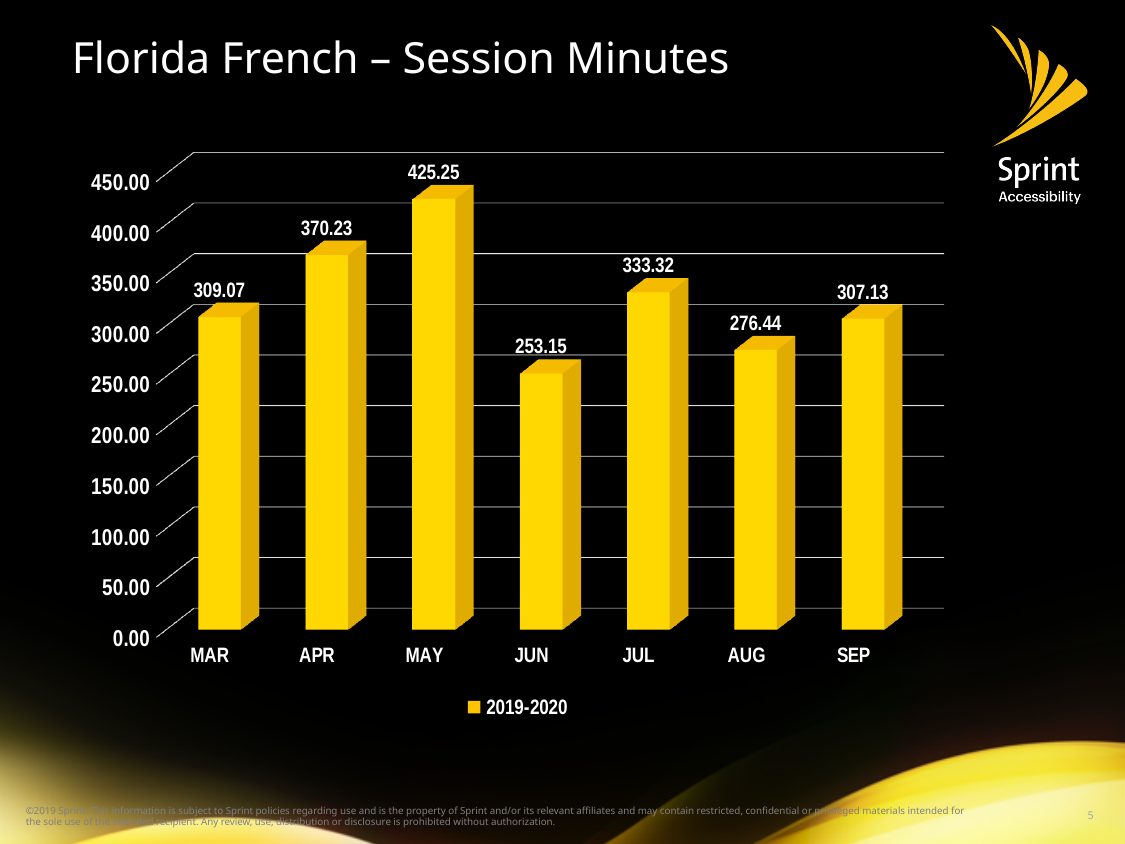
How many series does the legend list? 1 Which month has the highest session minutes? MAY How many months are shown on the x axis? 7 Is the value for AUG greater or less than 300.00? less What is the value for MAY? 425.25 Which month has the lowest session minutes? JUN What is the difference between the values for MAY and JUN? 172.10 What is the value for SEP? 307.13 Which is larger, the value for JUL or the value for AUG? JUL What kind of chart is shown on the slide? bar chart What is the difference between the values for APR and MAR? 61.16 What is the value for JUN? 253.15